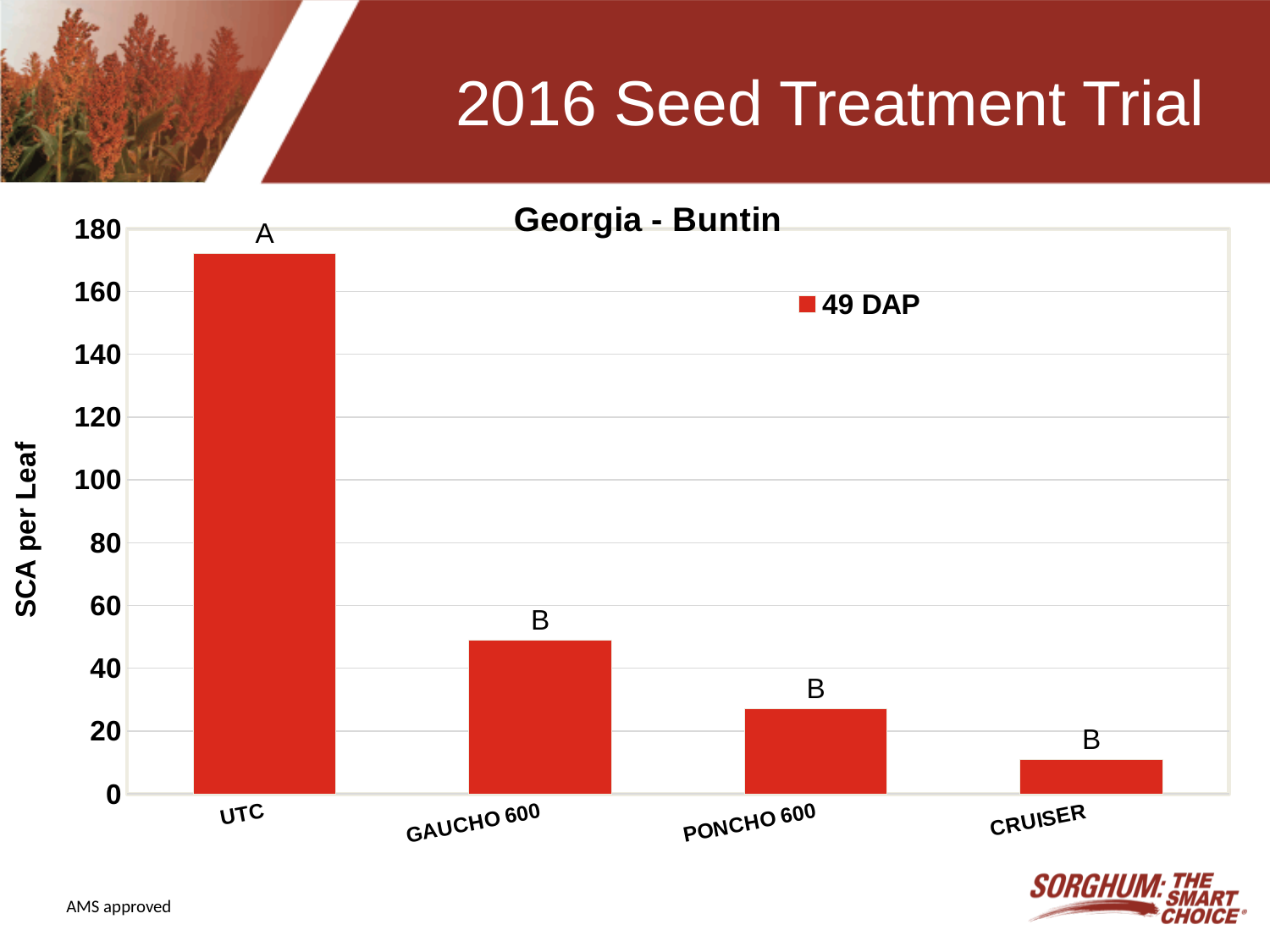
Is the value for PONCHO 600 greater or less than 20? greater How many treatment categories are plotted on the x axis? 4 What kind of chart is shown on the slide? bar chart What is the title of the chart? Georgia - Buntin What series name is shown in the chart legend? 49 DAP Is the value for UTC greater or less than 160? greater Which has a larger SCA per Leaf value, GAUCHO 600 or PONCHO 600? GAUCHO 600 Is the value for CRUISER greater or less than 20? less How many series does the chart legend list? 1 Which treatment has the highest SCA per Leaf? UTC Which treatment has the lowest SCA per Leaf? CRUISER